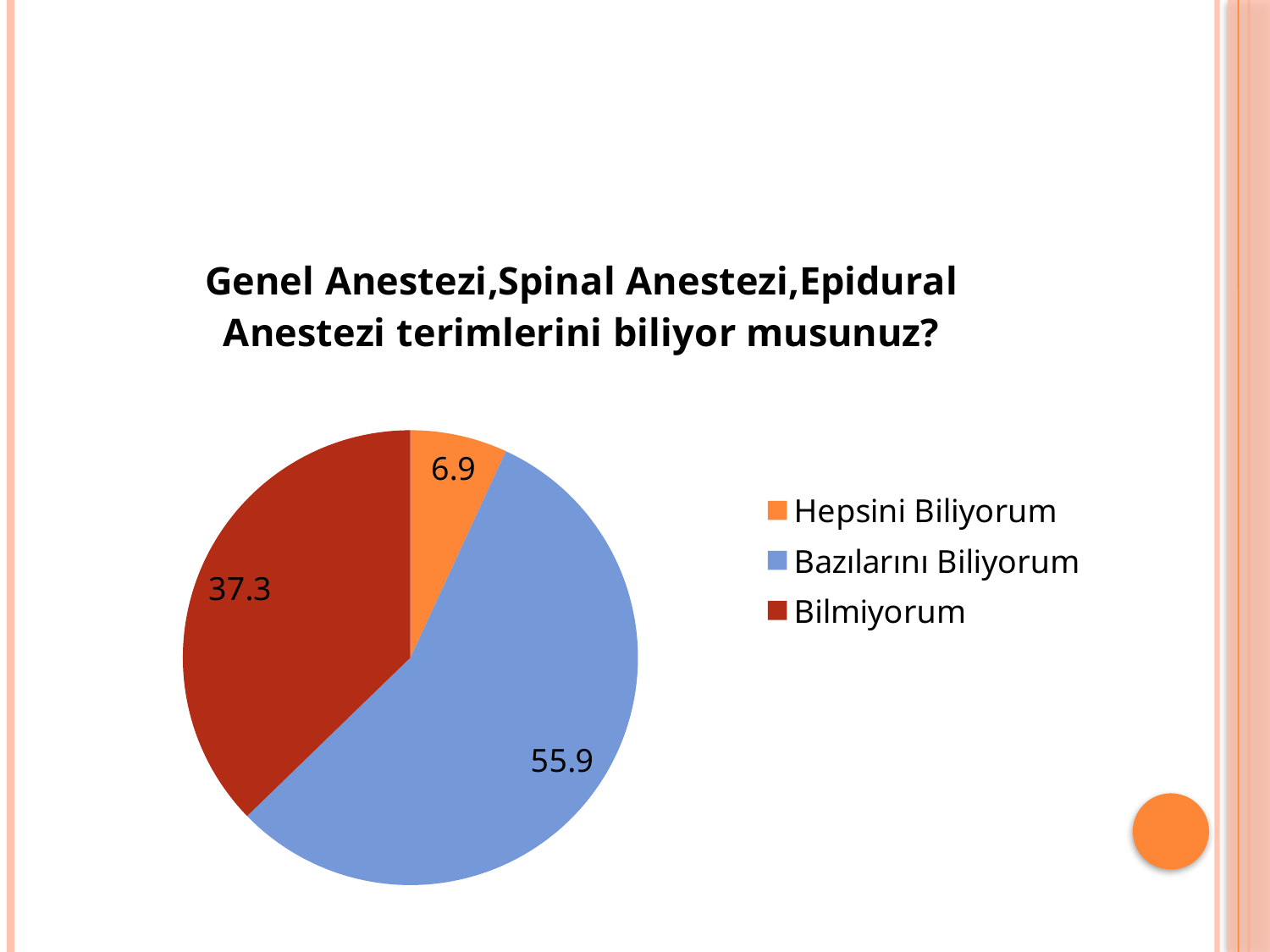
What colour is the slice for Bilmiyorum? red How many categories does the legend list? 3 Which is larger, the value for Bilmiyorum or the value for Hepsini Biliyorum? Bilmiyorum What is the difference between the values for Bazılarını Biliyorum and Bilmiyorum? 18.6 What is the value for Hepsini Biliyorum? 6.9 What is the difference between the values for Bilmiyorum and Hepsini Biliyorum? 30.4 Which category has the smallest slice? Hepsini Biliyorum Which category has the largest slice? Bazılarını Biliyorum What is the title of the chart? Genel Anestezi,Spinal Anestezi,Epidural Anestezi terimlerini biliyor musunuz? What is the value for Bazılarını Biliyorum? 55.9 What is the value for Bilmiyorum? 37.3 What kind of chart is shown on the slide? pie chart